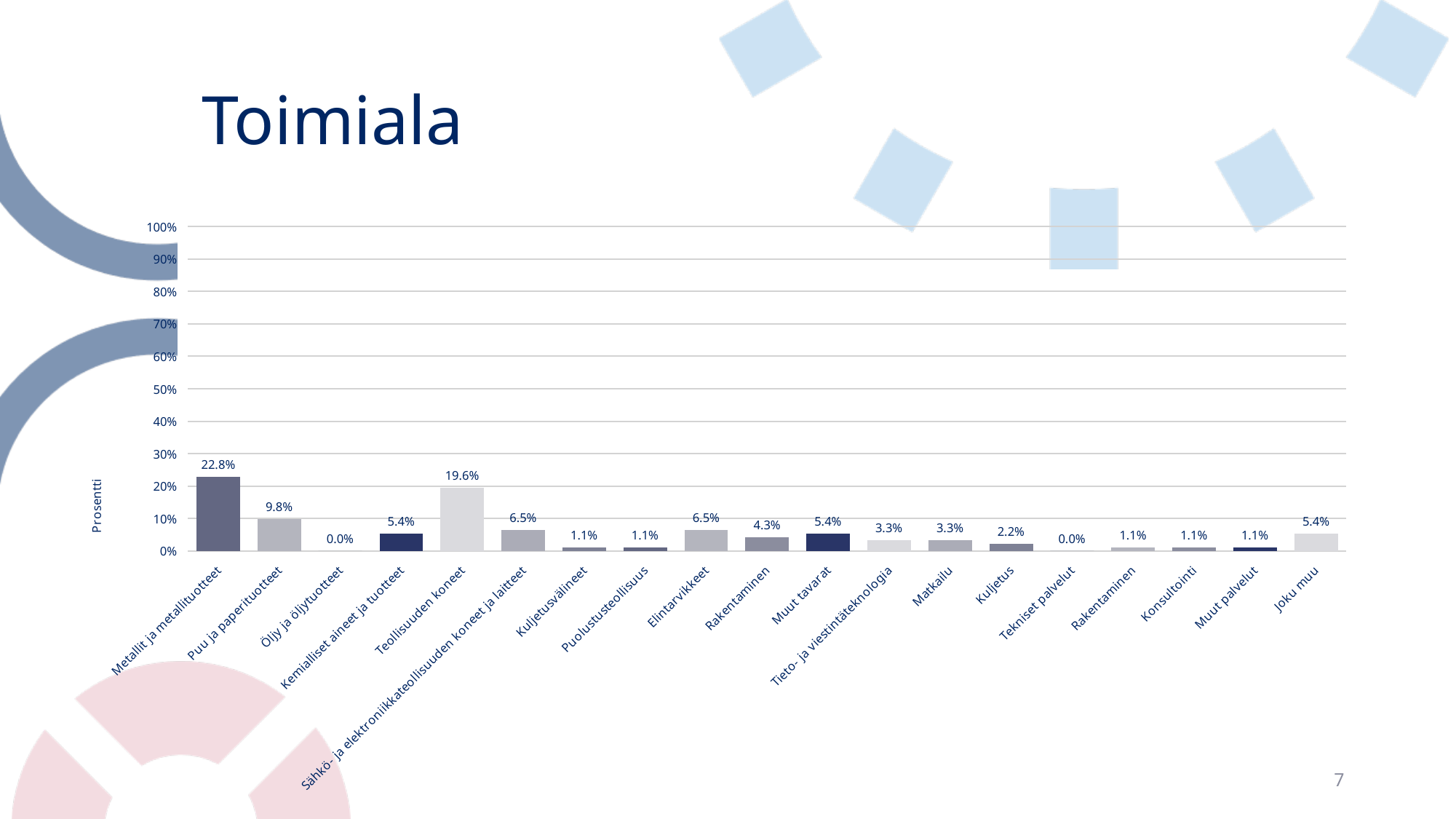
What is the value for Teollisuuden koneet? 19.6% Which category has the highest value? Metallit ja metallituotteet How many categories are shown on the x axis? 19 What is the value for Joku muu? 5.4% What kind of chart is shown on the slide? bar chart Is the value for Metallit ja metallituotteet greater or less than 20%? greater What is the value for Metallit ja metallituotteet? 22.8% What is the label on the vertical axis? Prosentti Which two categories have a value of 0.0%? Öljy ja öljytuotteet and Tekniset palvelut What is the difference between the values for Metallit ja metallituotteet and Teollisuuden koneet? 3.2% Which is larger, the value for Puu ja paperituotteet or the value for Elintarvikkeet? Puu ja paperituotteet What is the value for Puu ja paperituotteet? 9.8%